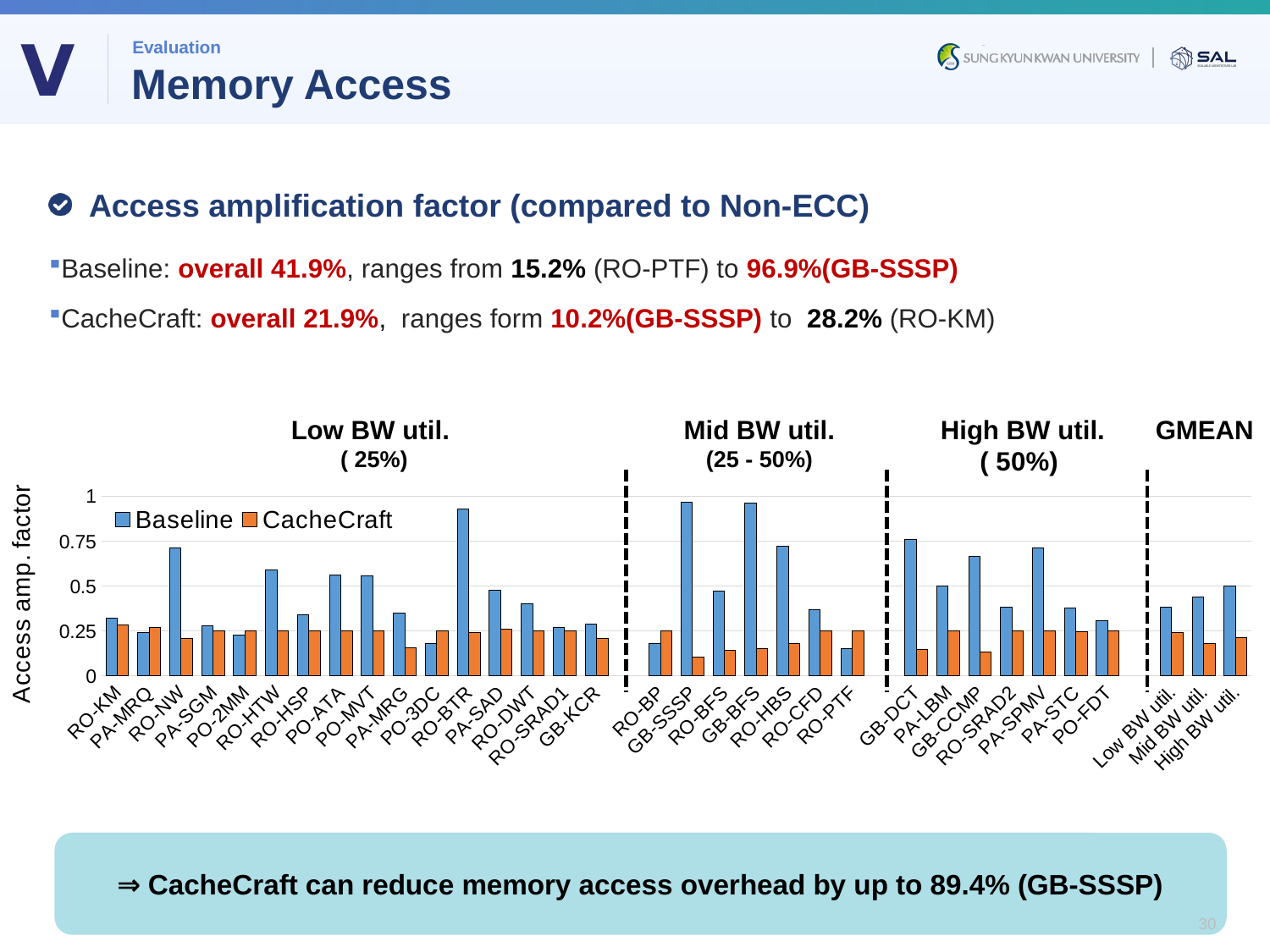
How many benchmarks are plotted in the Mid BW util. (25 - 50%) group? 7 Is the Baseline value for RO-BTR greater or less than 0.75? greater How many benchmarks are plotted in the High BW util. group? 7 How many series does the chart legend list? 2 For RO-NW, which is larger, the Baseline value or the CacheCraft value? Baseline What kind of chart is shown on the slide? bar chart Is the Baseline value for RO-HBS greater or less than 0.5? greater What is the label of the y axis of the chart? Access amp. factor Which benchmark has the highest Baseline access amplification factor? GB-SSSP What are the two series named in the chart legend? Baseline and CacheCraft Is the CacheCraft value for GB-SSSP greater or less than 0.25? less Which benchmark has the lowest Baseline access amplification factor? RO-PTF